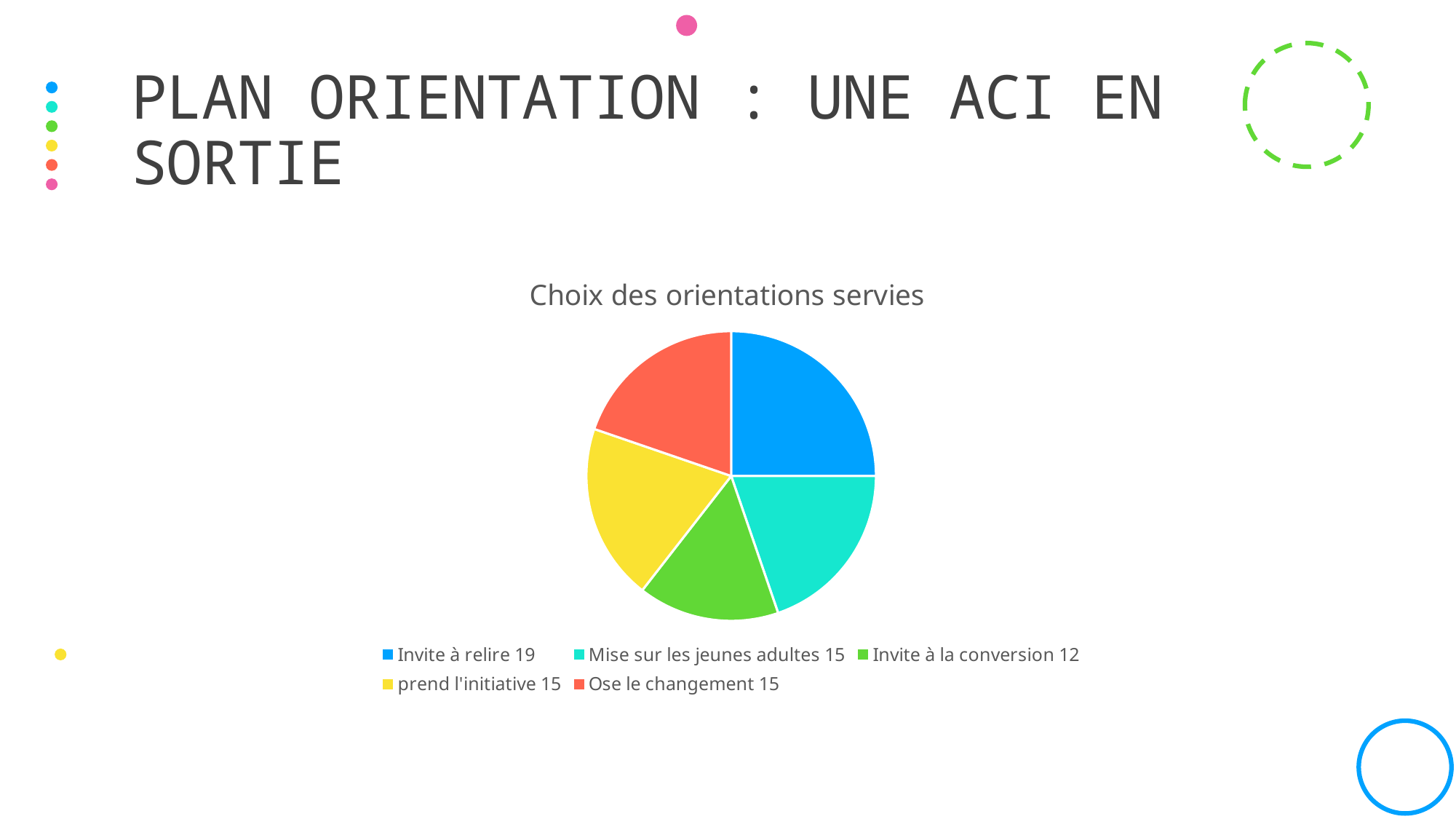
What value is shown for "Invite à relire"? 19 What is the total of all the values shown in the pie chart? 76 What colour is the slice for "prend l'initiative"? yellow What kind of chart is shown on the slide? pie chart How many slices does the pie chart have? 5 Which category has the smallest slice of the pie? Invite à la conversion Which category has the largest slice of the pie? Invite à relire Which is larger, the value for "Invite à relire" or the value for "Mise sur les jeunes adultes"? Invite à relire What value is shown for "Invite à la conversion"? 12 What is the title of the chart? Choix des orientations servies What is the difference between the values for "Invite à relire" and "Invite à la conversion"? 7 What value is shown for "Ose le changement"? 15